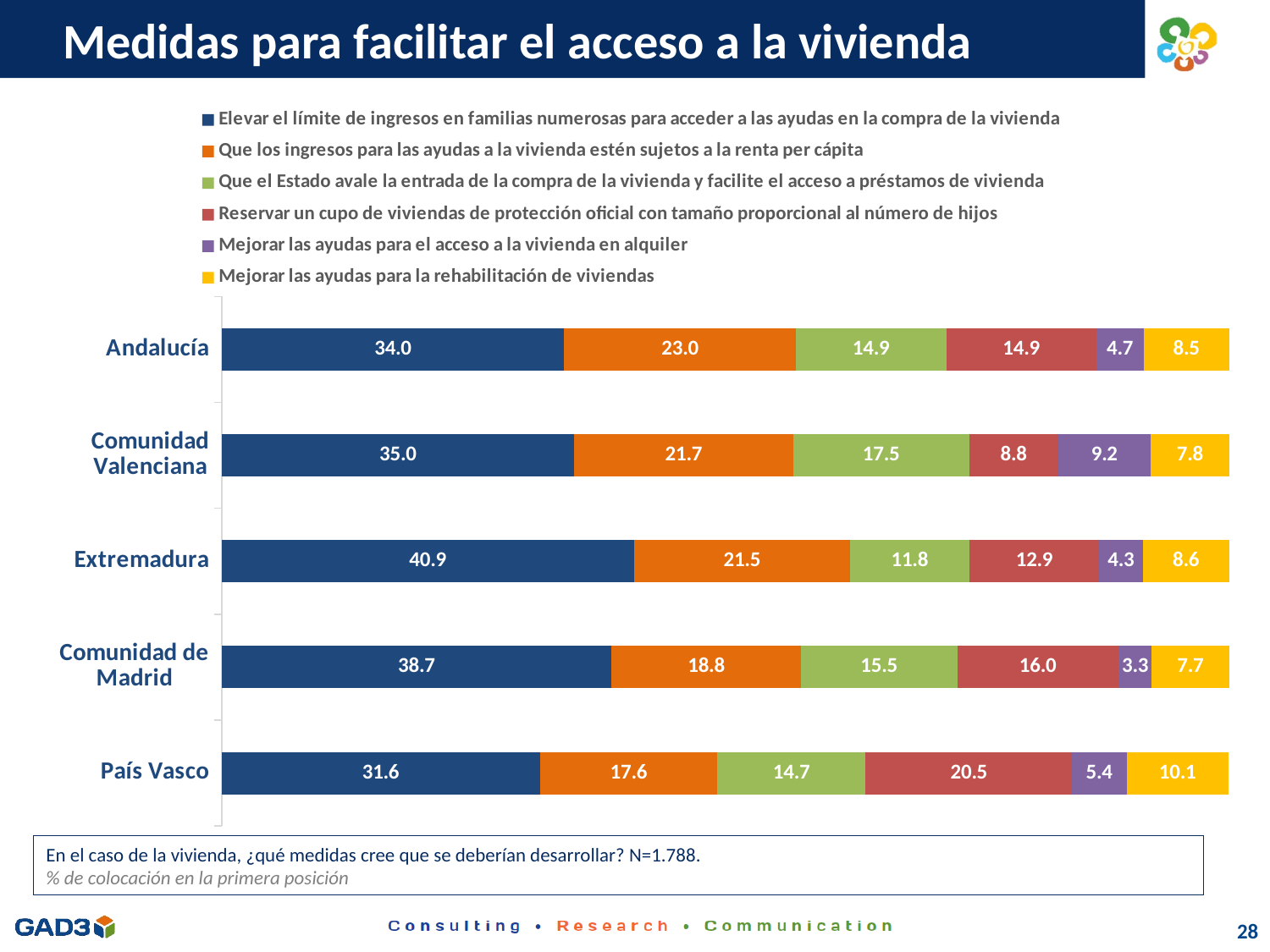
What is the total of the stacked bar for Andalucía? 100.0 How many series does the legend list? 6 What is the difference between Andalucía and País Vasco in the series "Elevar el límite de ingresos en familias numerosas para acceder a las ayudas en la compra de la vivienda"? 2.4 What kind of chart is shown on the slide? Stacked bar chart Which region has the lowest value for "Mejorar las ayudas para el acceso a la vivienda en alquiler"? Comunidad de Madrid What colour represents "Mejorar las ayudas para la rehabilitación de viviendas" in the chart? Yellow How many regions are shown in the chart? 5 Which region has the highest value for "Elevar el límite de ingresos en familias numerosas para acceder a las ayudas en la compra de la vivienda"? Extremadura What is the value for País Vasco in the series "Reservar un cupo de viviendas de protección oficial con tamaño proporcional al número de hijos"? 20.5 Which is larger for "Que los ingresos para las ayudas a la vivienda estén sujetos a la renta per cápita": Andalucía or Comunidad Valenciana? Andalucía What is the value for Extremadura in the series "Elevar el límite de ingresos en familias numerosas para acceder a las ayudas en la compra de la vivienda"? 40.9 What is the value for Comunidad de Madrid in the series "Mejorar las ayudas para la rehabilitación de viviendas"? 7.7